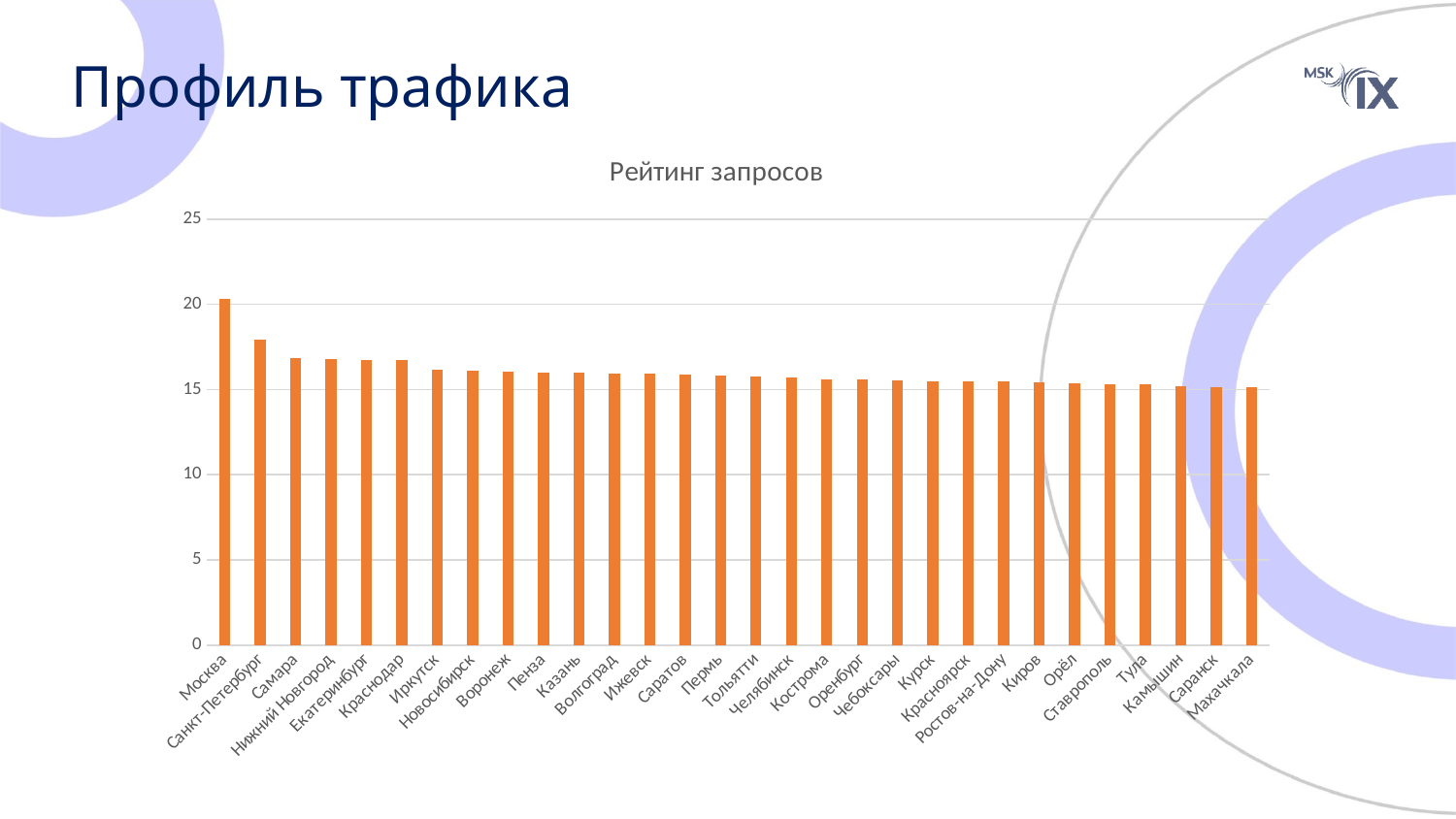
Is the value for Самара greater or less than 15? greater What is the title of the chart? Рейтинг запросов Is the value for Махачкала greater or less than 10? greater Do the values rise or fall moving from left to right along the x axis? fall How many cities are shown on the x axis of the chart? 30 Which is larger, the value for Москва or the value for Санкт-Петербург? Москва Which city has the highest value in the chart? Москва Which is larger, the value for Санкт-Петербург or the value for Самара? Санкт-Петербург What colour are the bars in the chart? orange What kind of chart is shown on the slide? bar chart Is the value for Москва greater or less than 15? greater